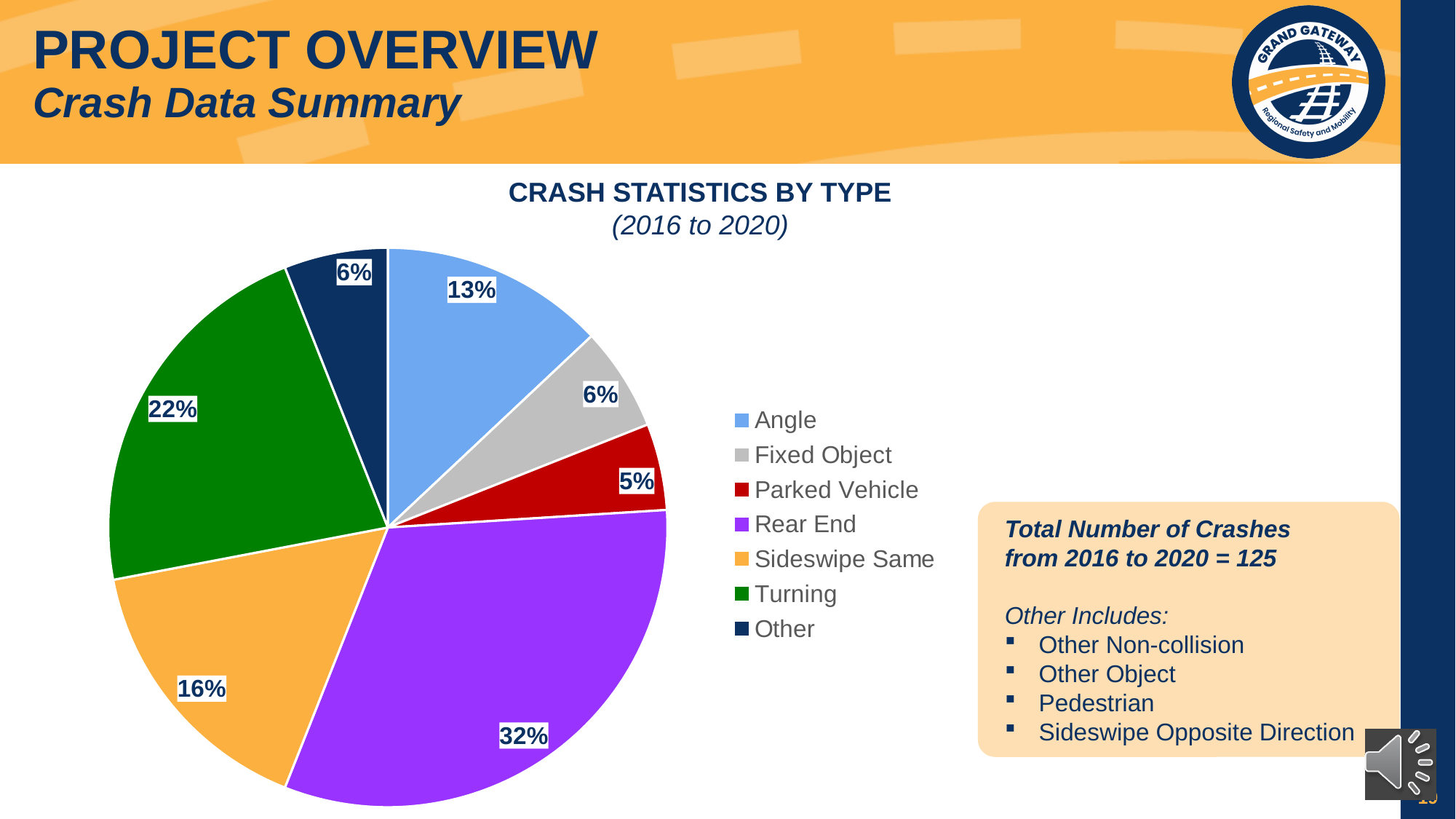
What percentage of crashes are Turning? 22% What percentage of crashes are Sideswipe Same? 16% What is the title of the chart? CRASH STATISTICS BY TYPE (2016 to 2020) How many crash types are listed in the legend? 7 Which has a larger share, Angle or Sideswipe Same? Sideswipe Same What percentage of crashes are Angle? 13% What percentage of crashes are Parked Vehicle? 5% What is the difference in percentage points between Rear End and Turning crashes? 10 Which crash type has the largest share of the pie? Rear End What percentage of crashes are Rear End? 32% What type of chart is shown on the slide? pie chart Which crash type has the smallest share of the pie? Parked Vehicle